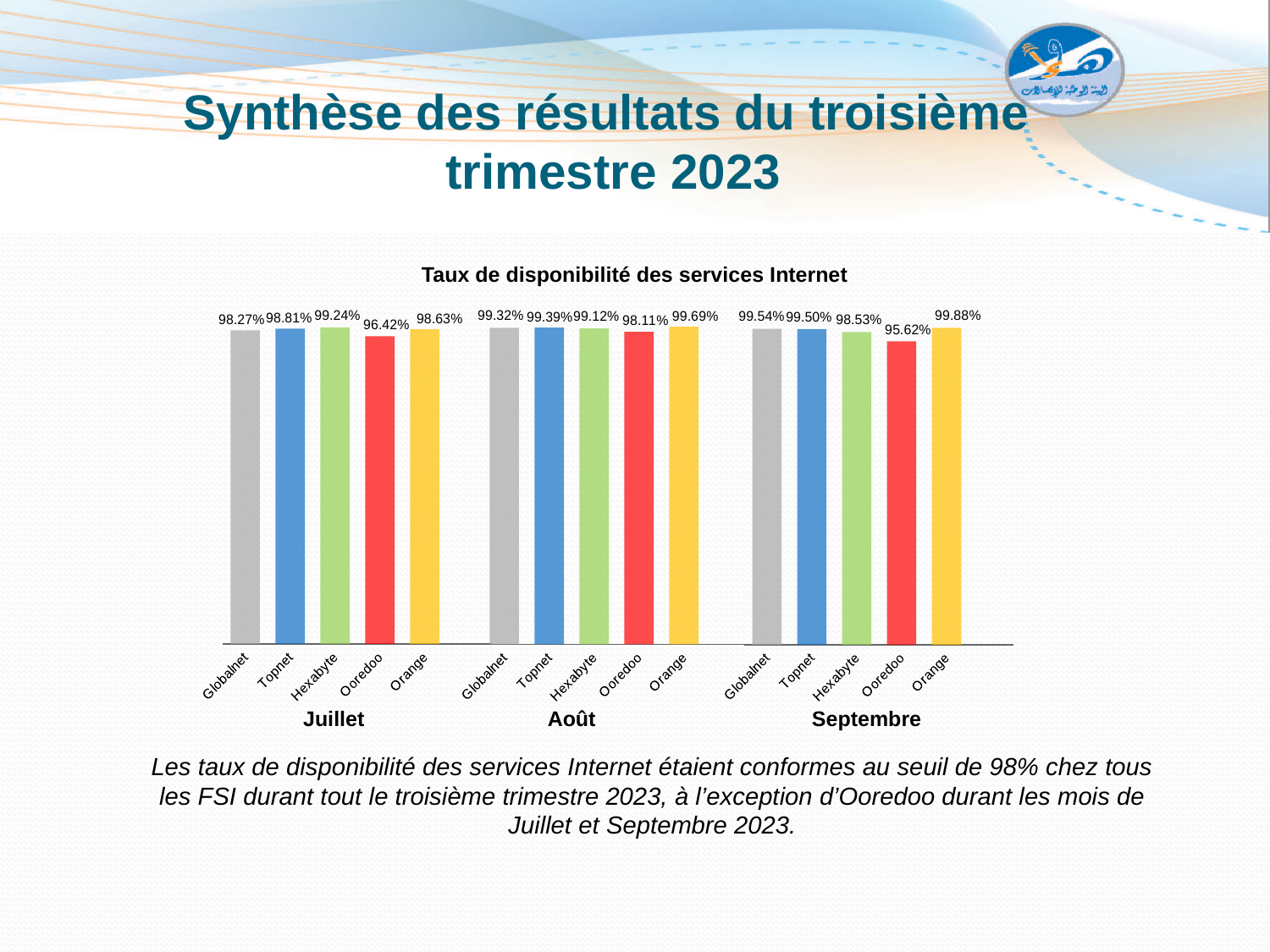
What is the availability rate for Ooredoo in Juillet? 96.42% What is the availability rate for Topnet in Août? 99.39% What is the difference between Orange's and Ooredoo's availability rates in Septembre? 4.26% What kind of chart is shown on the slide? Bar chart How many providers are shown for each month? 5 What is the title of the chart? Taux de disponibilité des services Internet What is the availability rate for Orange in Septembre? 99.88% Which provider has the lowest availability rate in Septembre? Ooredoo What is the availability rate for Hexabyte in Juillet? 99.24% What is the difference between Hexabyte's and Ooredoo's availability rates in Juillet? 2.82% Which provider has the highest availability rate in Août? Orange Which is larger: Ooredoo's availability rate in Août or in Septembre? Août